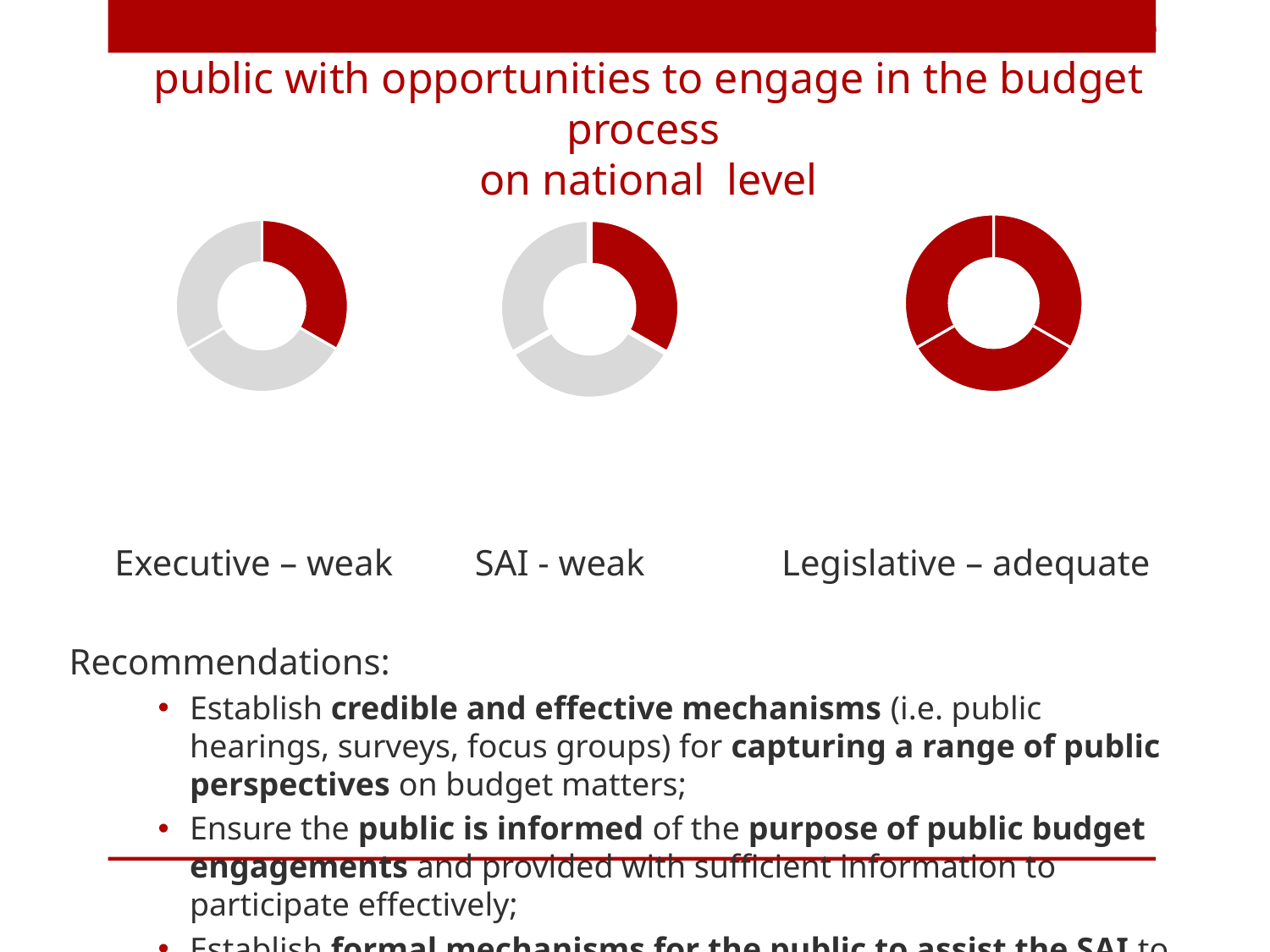
How many donut charts are shown on the slide? 3 What rating label is shown under the left donut chart? Executive – weak How many segments of the Legislative donut chart are coloured red? 3 Which donut chart is labelled as adequate? Legislative Which of the three donut charts has the most red segments? Legislative How many segments of the Executive donut chart are coloured red? 1 What kind of chart is used to show the Executive, SAI and Legislative ratings? donut chart